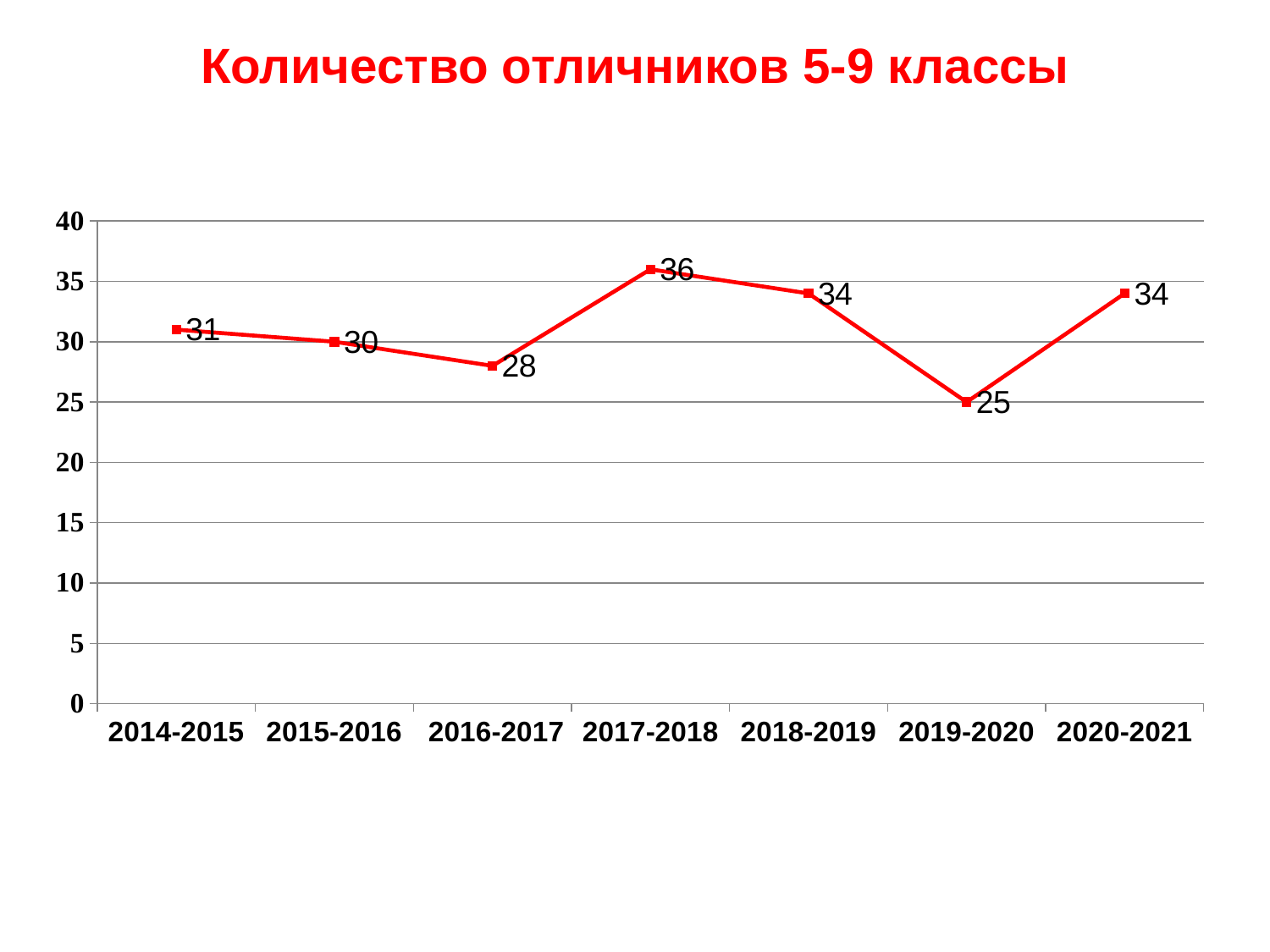
How many years are plotted on the chart? 7 Which is larger, the value for 2015-2016 or the value for 2016-2017? 2015-2016 Which year has the lowest value? 2019-2020 What is the title of the chart? Количество отличников 5-9 классы Is the value for 2018-2019 greater or less than 30? greater Which year has the highest value? 2017-2018 What is the difference between the values for 2017-2018 and 2019-2020? 11 What is the value for 2019-2020? 25 Do the values rise or fall from 2014-2015 to 2016-2017? fall What is the value for 2017-2018? 36 What is the value for 2014-2015? 31 What kind of chart is shown on the slide? line chart